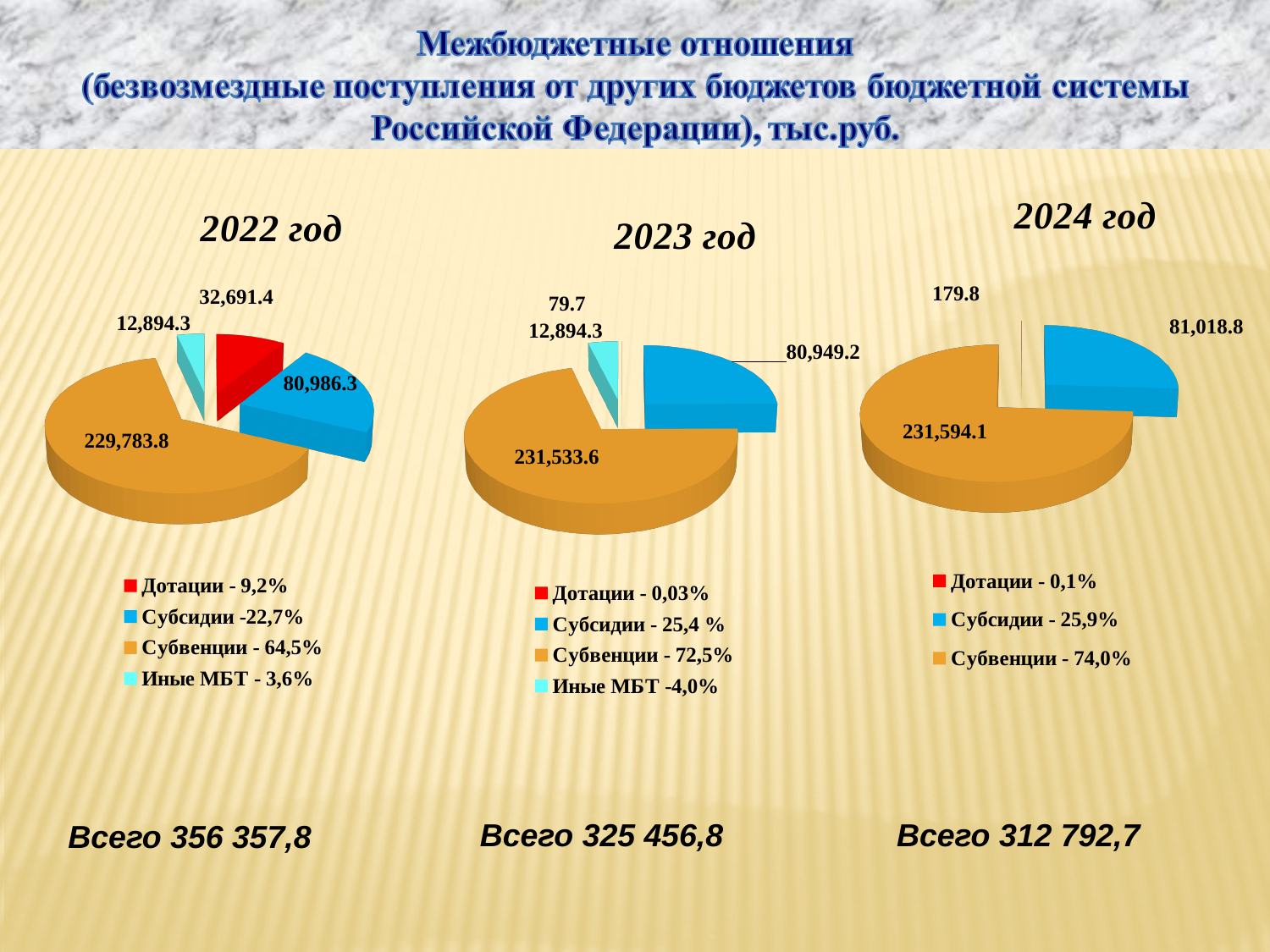
How many categories does the 2024 год pie chart's legend list? 3 In the 2022 год pie chart, what share of the pie does Субсидии have according to the legend? 22,7% In the 2024 год pie chart, what is the value for Дотации? 179.8 In the 2024 год pie chart, what share of the pie does Субвенции have according to the legend? 74,0% In the 2023 год pie chart, which category has the smallest slice? Дотации What kind of chart is used for 2023 год? Pie chart In the 2022 год pie chart, which is larger: Дотации or Иные МБТ? Дотации In the 2023 год pie chart, what is the value for Субсидии? 80,949.2 In the 2022 год pie chart, what is the value for Субвенции? 229,783.8 In the 2022 год pie chart, which category has the largest slice? Субвенции How many categories does the 2022 год pie chart's legend list? 4 In the 2023 год pie chart, what is the difference between Субвенции and Субсидии? 150,584.4